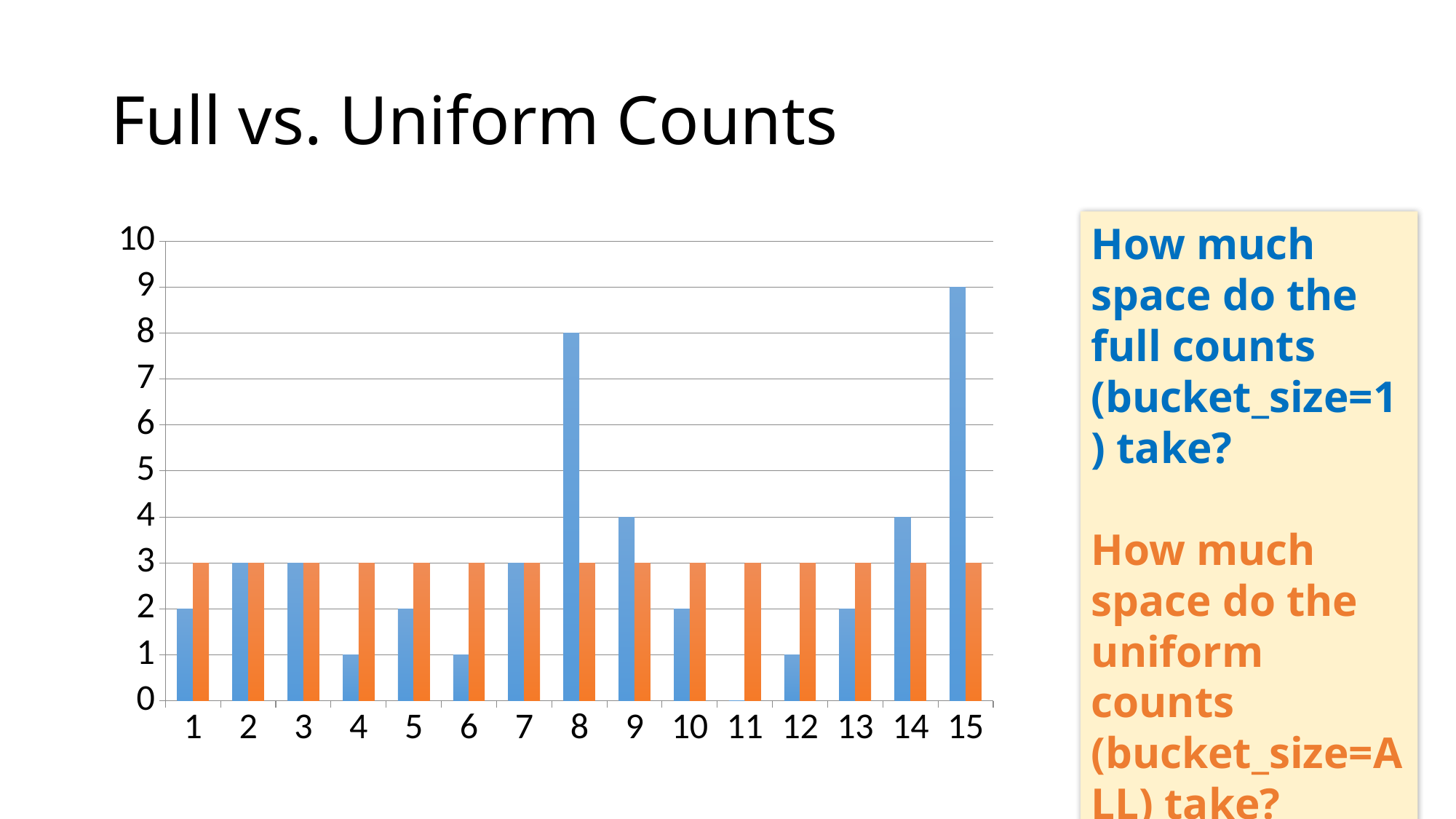
How many categories are shown on the x axis of the chart? 15 What is the value of the blue bar for category 15? 9 What is the value of the blue bar for category 8? 8 For category 8, which bar is larger, the blue bar or the orange bar? the blue bar What is the value of the orange bar for category 1? 3 What kind of chart is shown on the slide? bar chart Which category has the lowest blue bar? 11 What is the difference between the blue bar for category 15 and the blue bar for category 8? 1 What is the value of the blue bar for category 4? 1 Which category has the highest blue bar? 15 Do the orange bars rise, fall, or stay constant across the categories? stay constant What is the title of the slide containing the chart? Full vs. Uniform Counts